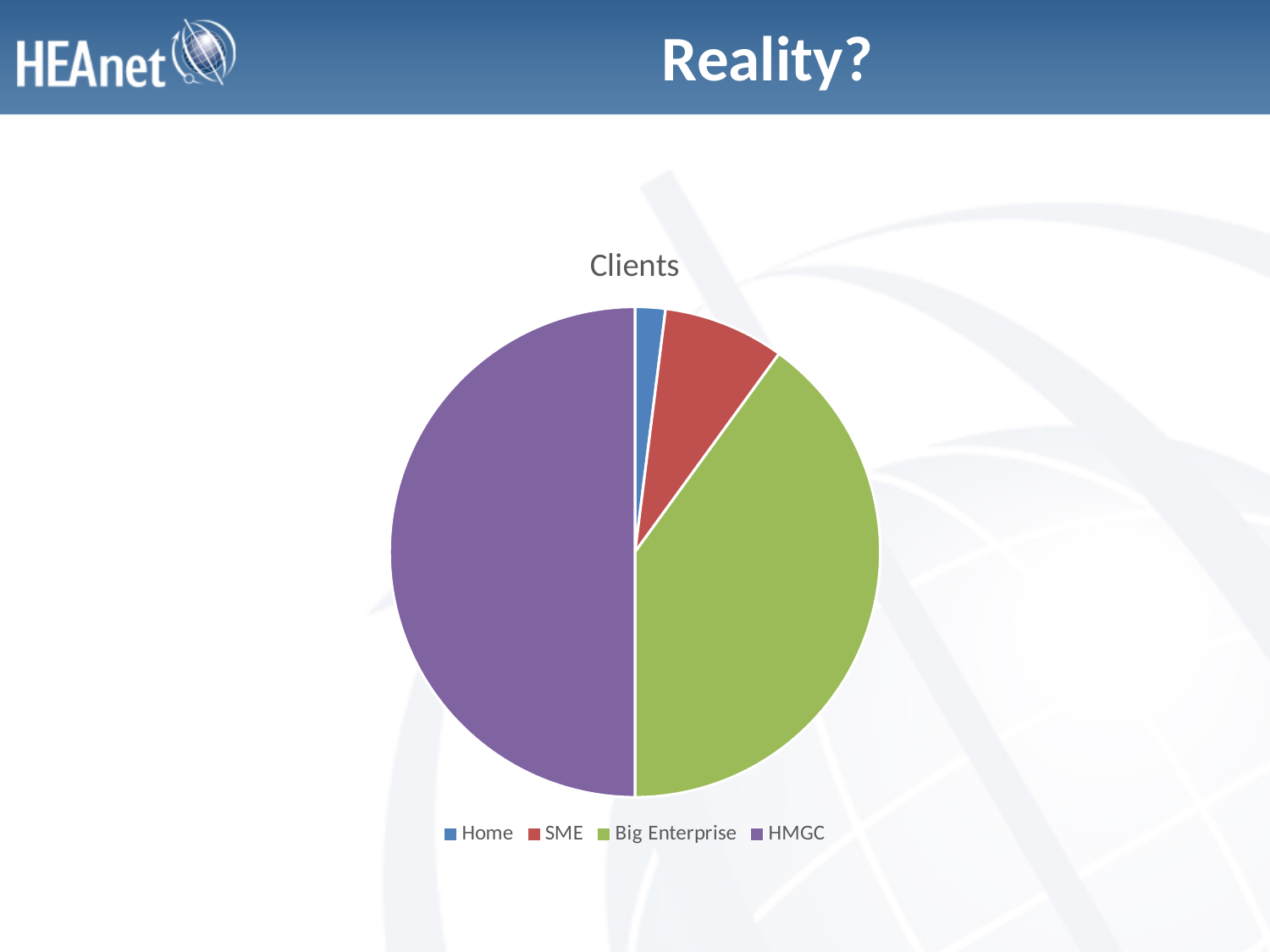
What kind of chart is shown on the slide? Pie chart How many entries does the legend list? 4 Which slice is larger, HMGC or Big Enterprise? HMGC How many categories (slices) does the pie chart have? 4 What colour is the HMGC slice? Purple Which category has the smallest slice of the pie? Home Which category has the largest slice of the pie? HMGC Which slice is larger, Big Enterprise or SME? Big Enterprise What is the title of the chart? Clients Which slice is larger, SME or Home? SME